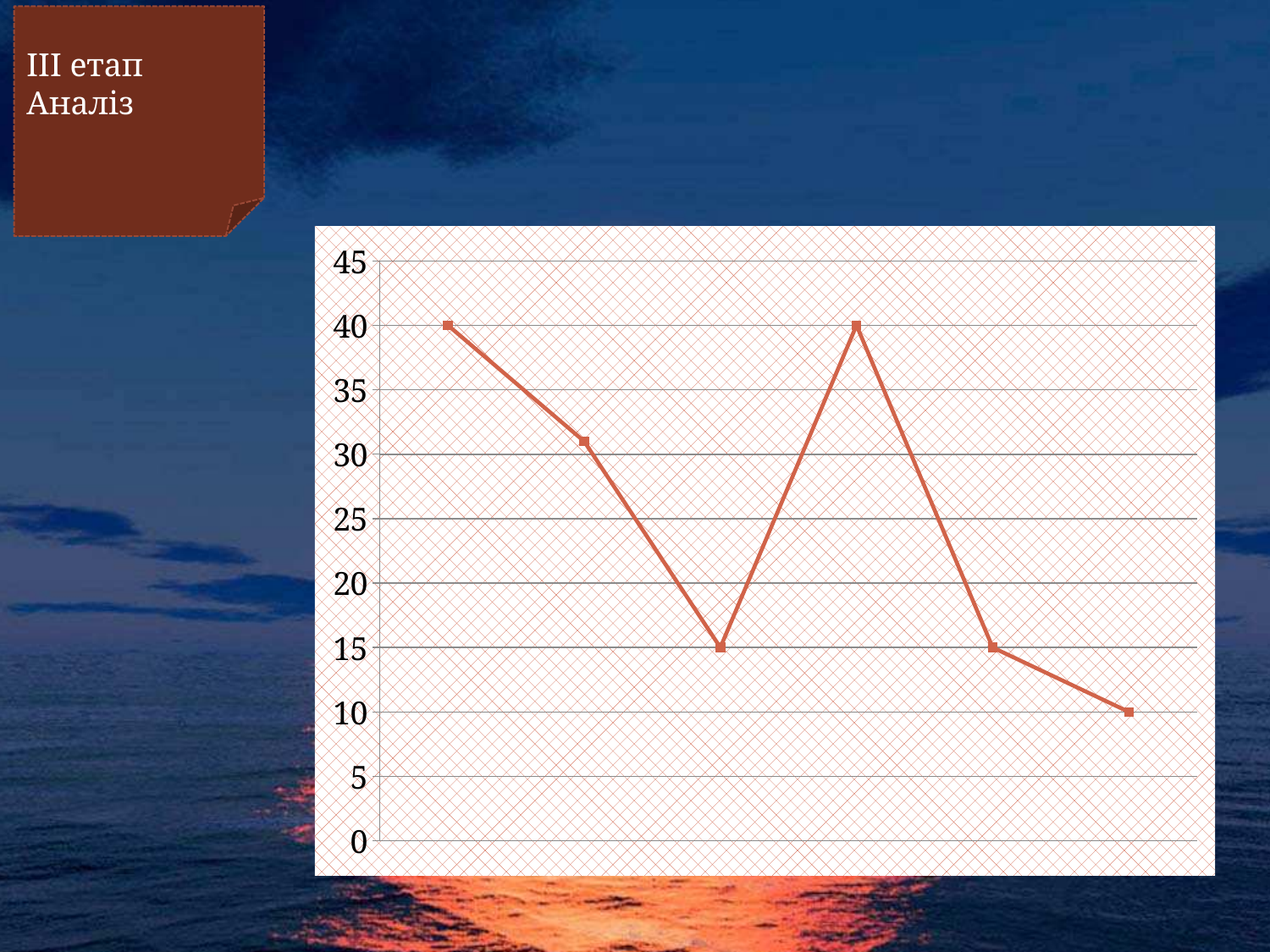
What is the value of the third point on the line? 15 Which point has the lowest value on the line? the last (sixth) point How many data points are plotted on the line? 6 What kind of chart is shown on the slide? line chart What is the value of the last (rightmost) point on the line? 10 What is the value of the first (leftmost) point on the line? 40 What is the highest value shown on the vertical axis? 45 Which is larger, the value of the first point or the value of the last point? the first point Does the line end higher or lower than it starts? lower Is the value of the fifth point greater or less than 20? less What is the difference between the first point and the last point? 30